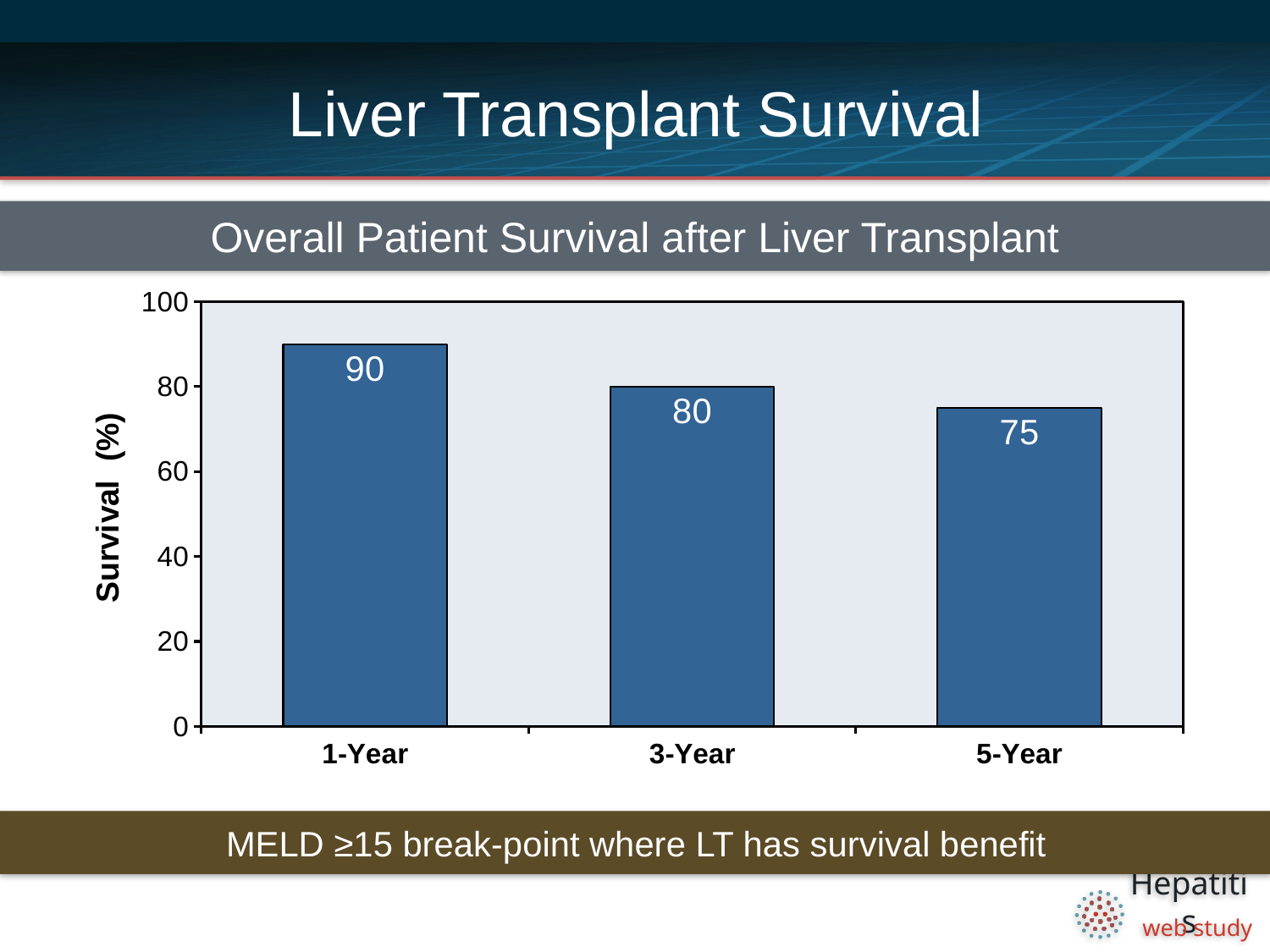
What kind of chart is shown on the slide? bar chart What is the survival value for 1-Year? 90 Is the value for 5-Year greater or less than 80? less What is the survival value for 3-Year? 80 Do the values rise or fall from 1-Year to 5-Year? fall What is the survival value for 5-Year? 75 Which is larger, the 1-Year value or the 3-Year value? 1-Year What is the difference between the 3-Year and 5-Year survival values? 5 Which category has the lowest survival value? 5-Year Which category has the highest survival value? 1-Year What is the difference between the 1-Year and 5-Year survival values? 15 How many categories are shown on the x axis? 3